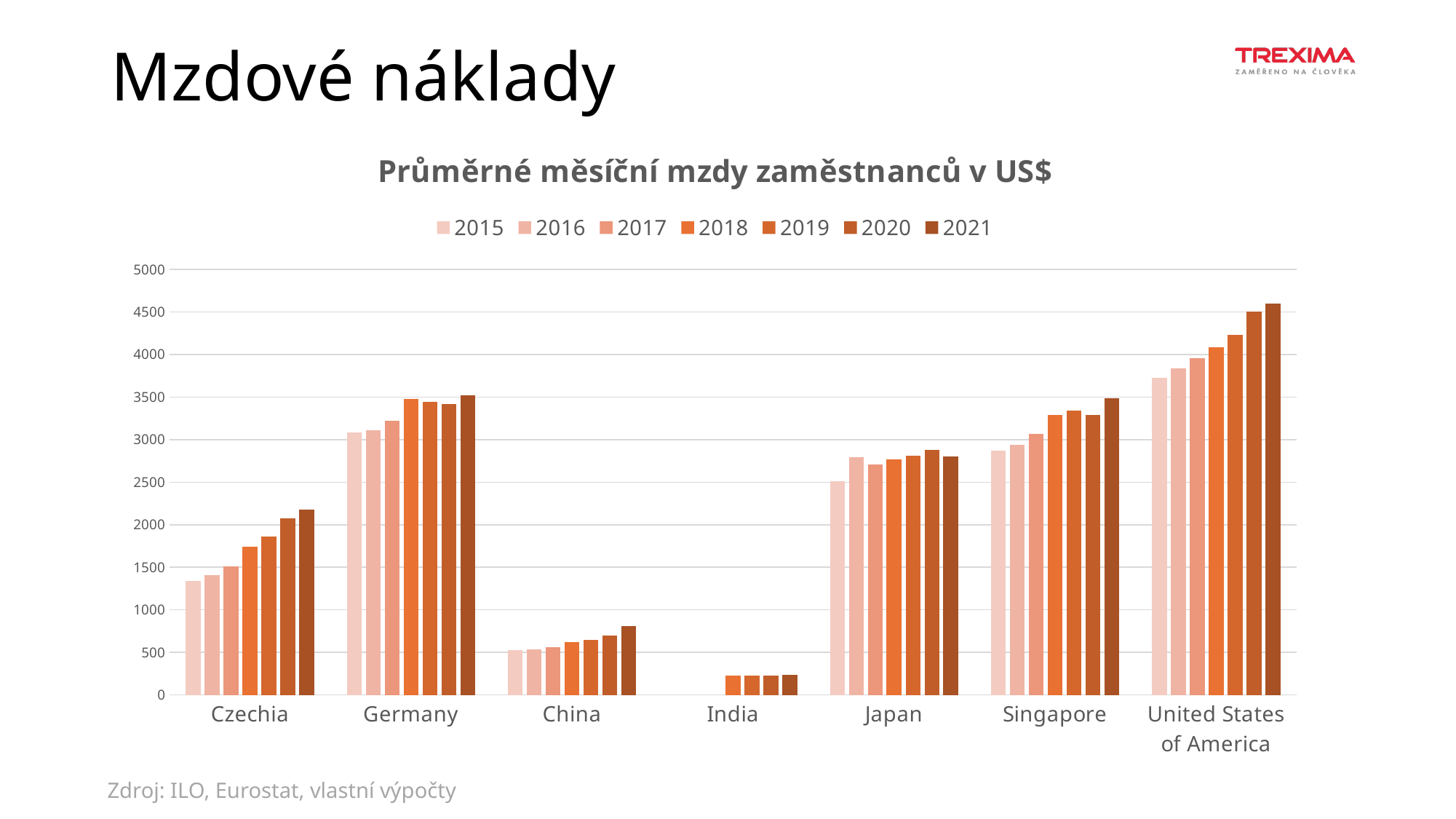
Is the value for Germany in 2015 greater or less than 3000? greater Do the values for Czechia rise or fall from 2015 to 2021? rise How many countries are shown on the x axis? 7 Which is larger in 2021: the value for Singapore or the value for Japan? Singapore What kind of chart is shown on the slide? bar chart Is the value for China in 2021 greater or less than 1000? less Is the value for United States of America in 2021 greater or less than 4000? greater Which country has the highest average monthly wage in 2021? United States of America What is the title of the chart? Průměrné měsíční mzdy zaměstnanců v US$ How many series (years) does the legend list? 7 Which country has the lowest average monthly wage in 2021? India